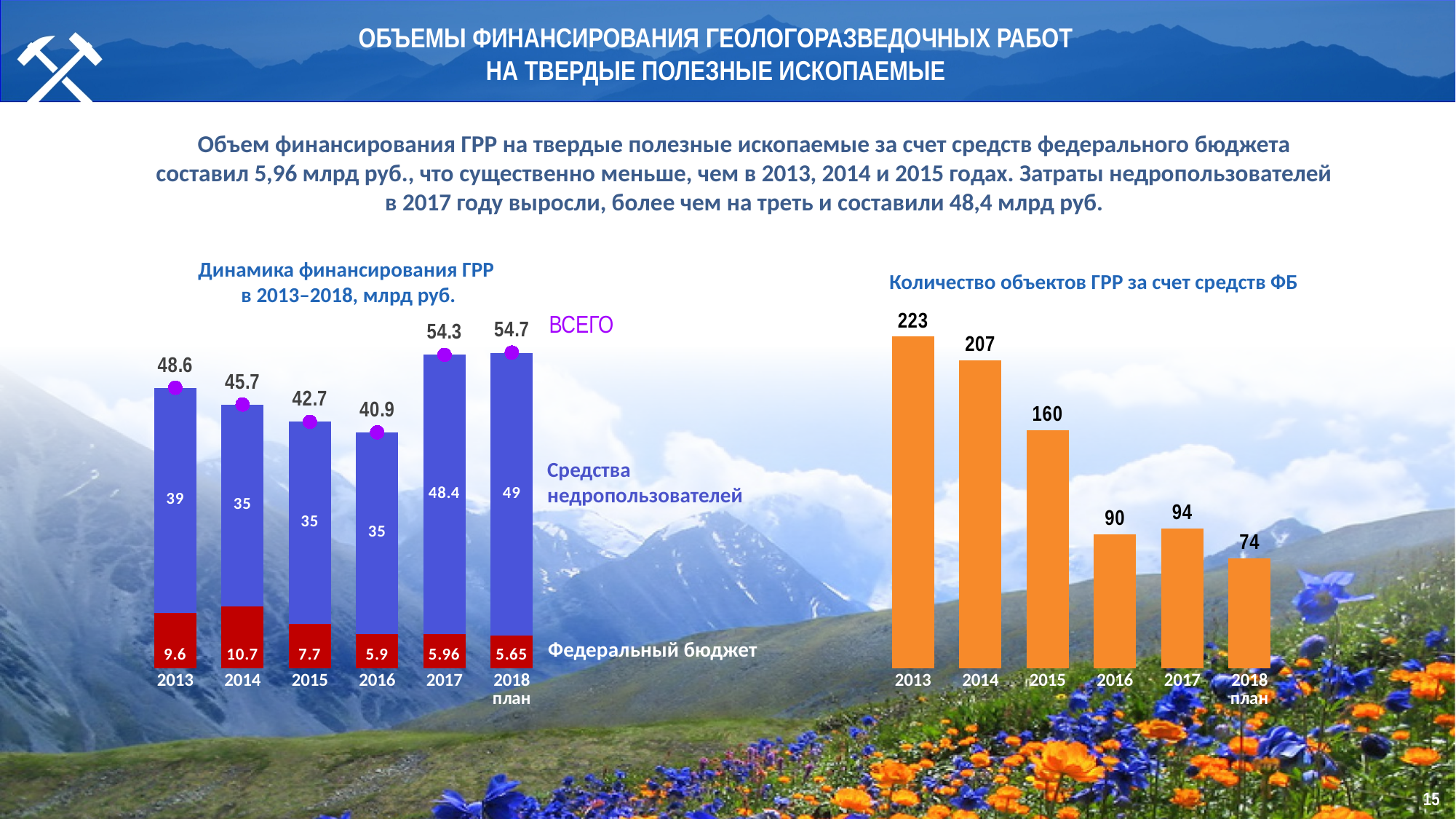
In the chart 'Динамика финансирования ГРР в 2013–2018, млрд руб.', what is the Средства недропользователей value for 2017? 48.4 In the chart 'Динамика финансирования ГРР в 2013–2018, млрд руб.', how many years are shown on the x axis? 6 In the chart 'Динамика финансирования ГРР в 2013–2018, млрд руб.', how many stacked series make up each bar? 2 In the chart 'Количество объектов ГРР за счет средств ФБ', what is the value for 2015? 160 In the chart 'Количество объектов ГРР за счет средств ФБ', what is the difference between the values for 2013 and 2014? 16 In the chart 'Динамика финансирования ГРР в 2013–2018, млрд руб.', what is the Федеральный бюджет value for 2013? 9.6 In the chart 'Динамика финансирования ГРР в 2013–2018, млрд руб.', what is the ВСЕГО total for 2016? 40.9 In the chart 'Количество объектов ГРР за счет средств ФБ', which year has the lowest value? 2018 план In the chart 'Динамика финансирования ГРР в 2013–2018, млрд руб.', which year has the lowest ВСЕГО total? 2016 What kind of chart is 'Количество объектов ГРР за счет средств ФБ'? Bar chart In the chart 'Динамика финансирования ГРР в 2013–2018, млрд руб.', what is the difference between the Федеральный бюджет values for 2014 and 2015? 3 In the chart 'Динамика финансирования ГРР в 2013–2018, млрд руб.', which year has the highest Федеральный бюджет value? 2014